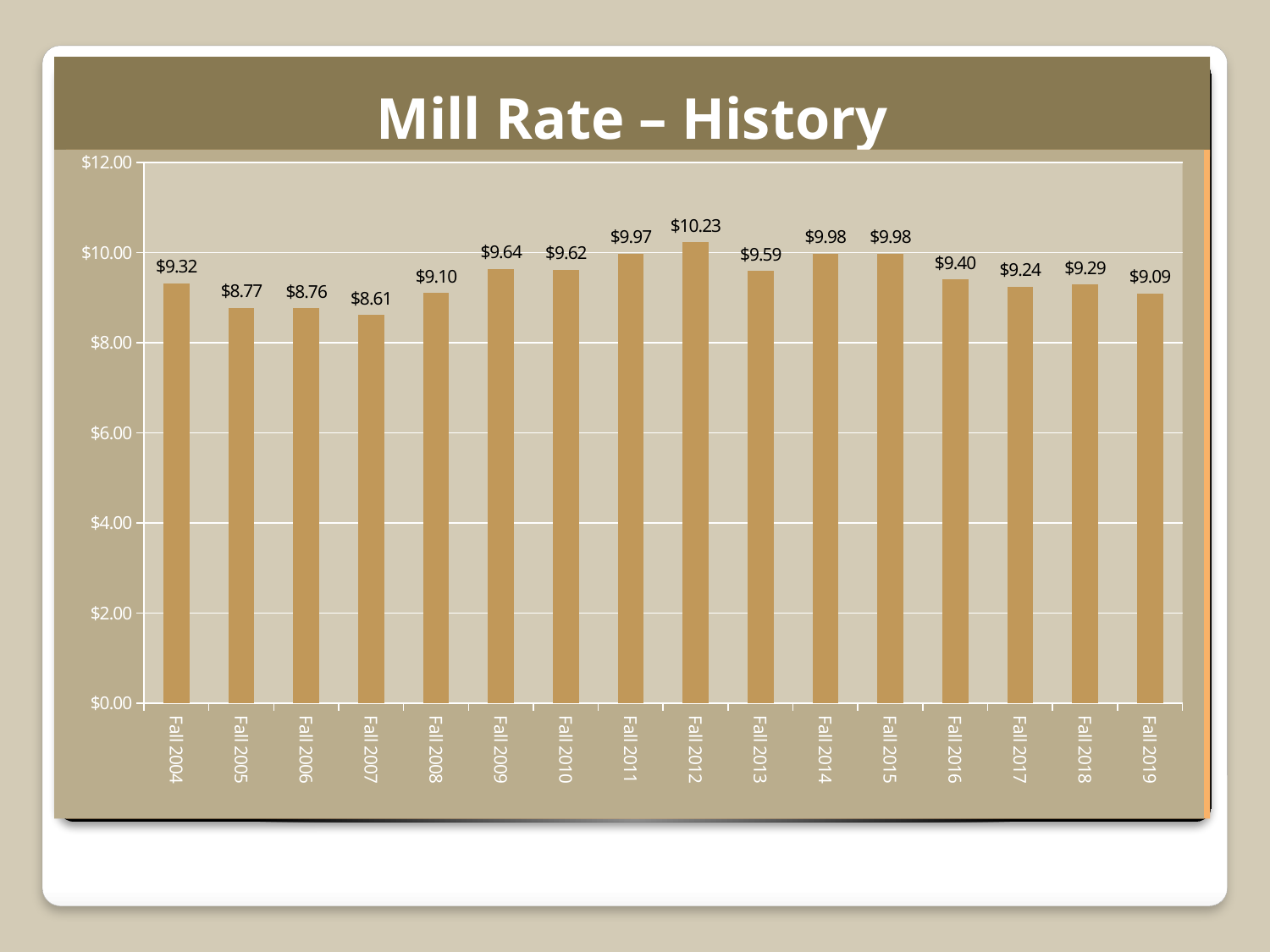
What is the title of the chart? Mill Rate – History Which period has the lowest mill rate? Fall 2007 What is the difference between the mill rate in Fall 2012 and Fall 2007? $1.62 Is the mill rate for Fall 2012 greater or less than $10.00? greater What is the mill rate for Fall 2007? $8.61 Which period has the highest mill rate? Fall 2012 What kind of chart is shown on the slide? Bar chart What is the mill rate for Fall 2019? $9.09 Which is larger, the mill rate for Fall 2009 or Fall 2016? Fall 2009 What is the difference between the mill rate in Fall 2004 and Fall 2019? $0.23 How many periods are shown on the chart? 16 What is the mill rate for Fall 2012? $10.23